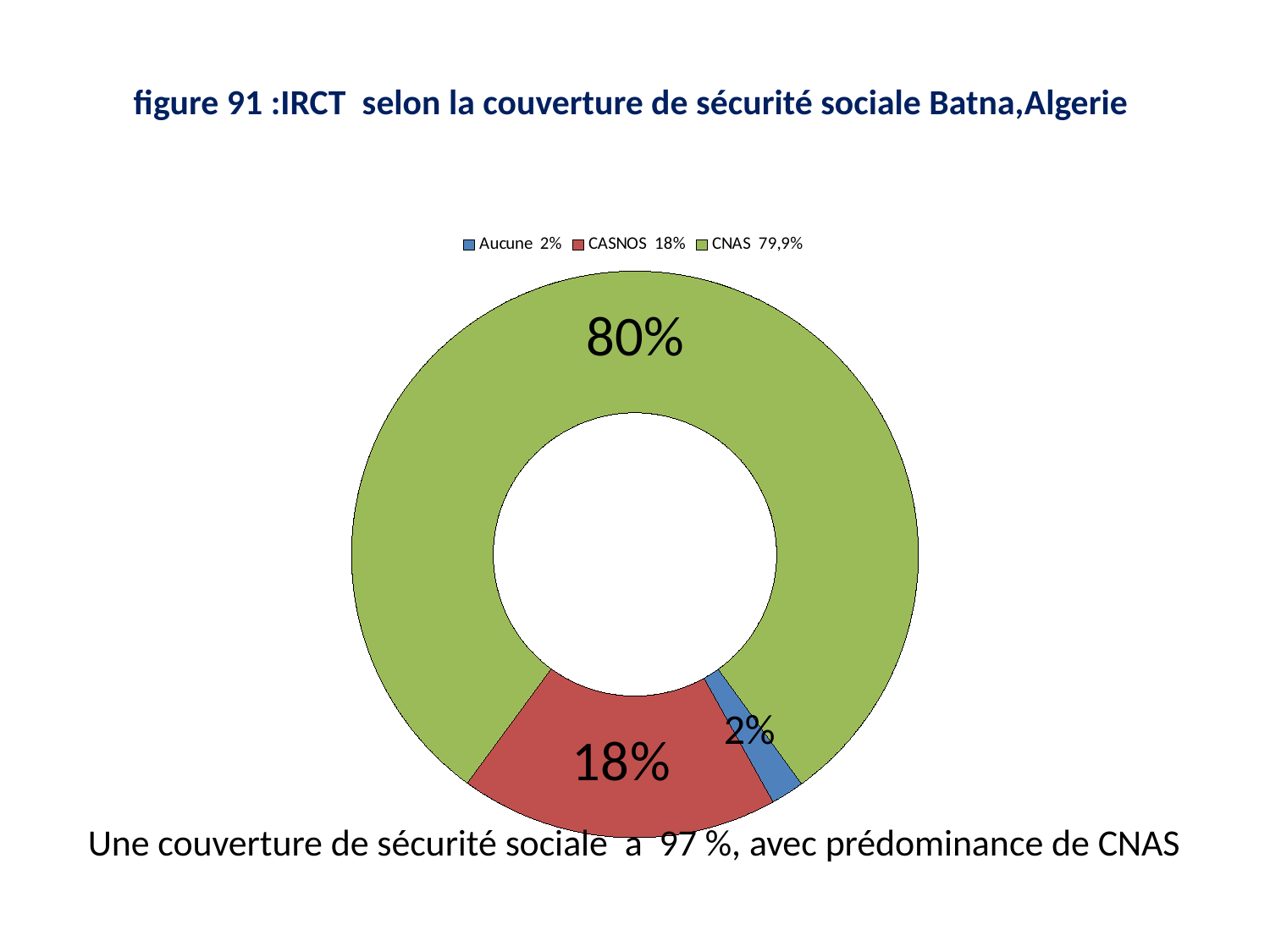
What is the title of the figure on the slide? figure 91 :IRCT selon la couverture de sécurité sociale Batna,Algerie Which category has the largest share of the chart? CNAS How many categories are shown in the chart? 3 What percentage label is shown on the CNAS slice? 80% What percentage label is shown on the Aucune slice? 2% What value does the legend give for CNAS? 79,9% Which category has the smallest share of the chart? Aucune What colour is the CNAS slice? green What kind of chart is shown on the slide? doughnut chart By how many percentage points does the CASNOS slice label exceed the Aucune slice label? 16 percentage points Which is larger, the share for CASNOS or the share for Aucune? CASNOS What percentage label is shown on the CASNOS slice? 18%